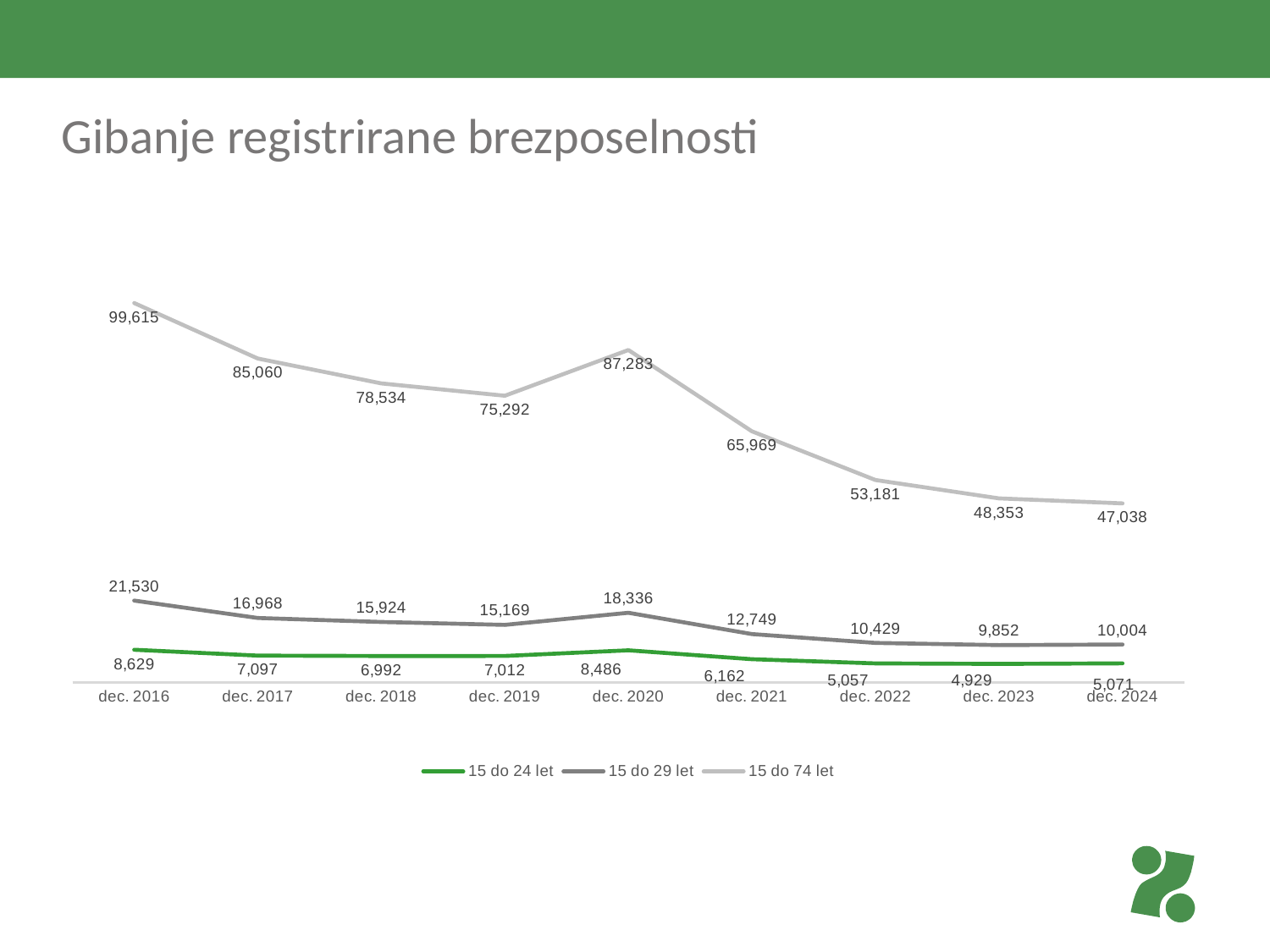
What is the difference between the 15 do 74 let values in dec. 2016 and dec. 2024? 52,577 What is the value for the 15 do 74 let series in dec. 2016? 99,615 In which period is the 15 do 74 let series lowest? dec. 2024 What is the value for the 15 do 29 let series in dec. 2020? 18,336 What is the value for the 15 do 24 let series in dec. 2023? 4,929 What kind of chart is shown on the slide? line chart How many series does the legend list? 3 What is the title of the chart? Gibanje registrirane brezposelnosti In which period is the 15 do 29 let series highest? dec. 2016 Which is larger for the 15 do 24 let series: dec. 2020 or dec. 2021? dec. 2020 How many time points are plotted on the x axis? 9 Does the 15 do 74 let series generally rise or fall from dec. 2020 to dec. 2024? fall